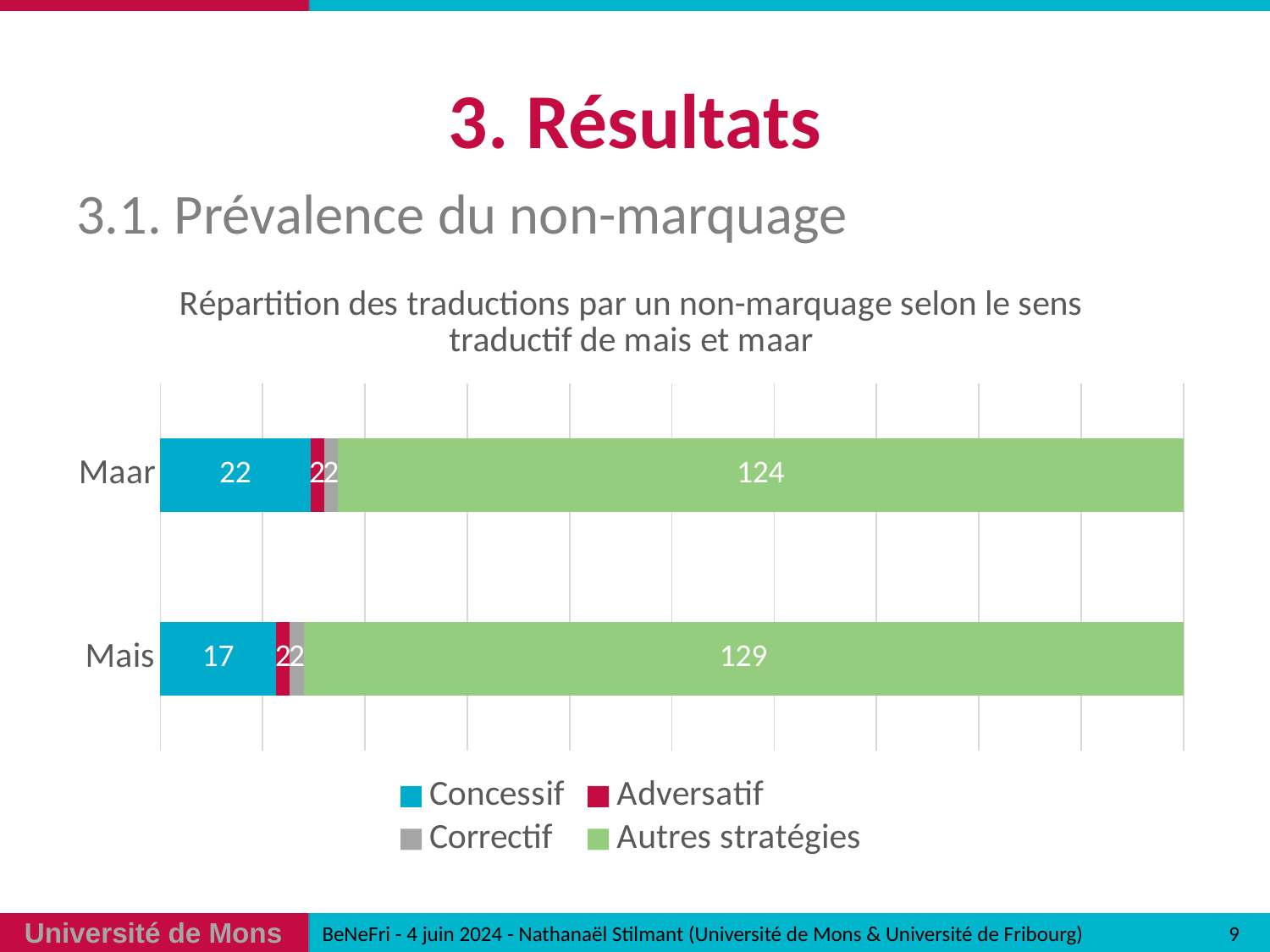
What type of chart is shown on the slide? Stacked bar chart How many categories are plotted on the chart? 2 How many series does the legend list? 4 Which series is shown in green in the legend? Autres stratégies What is the Concessif value for Mais? 17 What is the Concessif value for Maar? 22 What is the difference between the Concessif values for Maar and Mais? 5 What is the Autres stratégies value for Mais? 129 Which category has the higher Autres stratégies value, Maar or Mais? Mais What is the Autres stratégies value for Maar? 124 What is the title of the chart? Répartition des traductions par un non-marquage selon le sens traductif de mais et maar What is the difference between the Autres stratégies values for Mais and Maar? 5